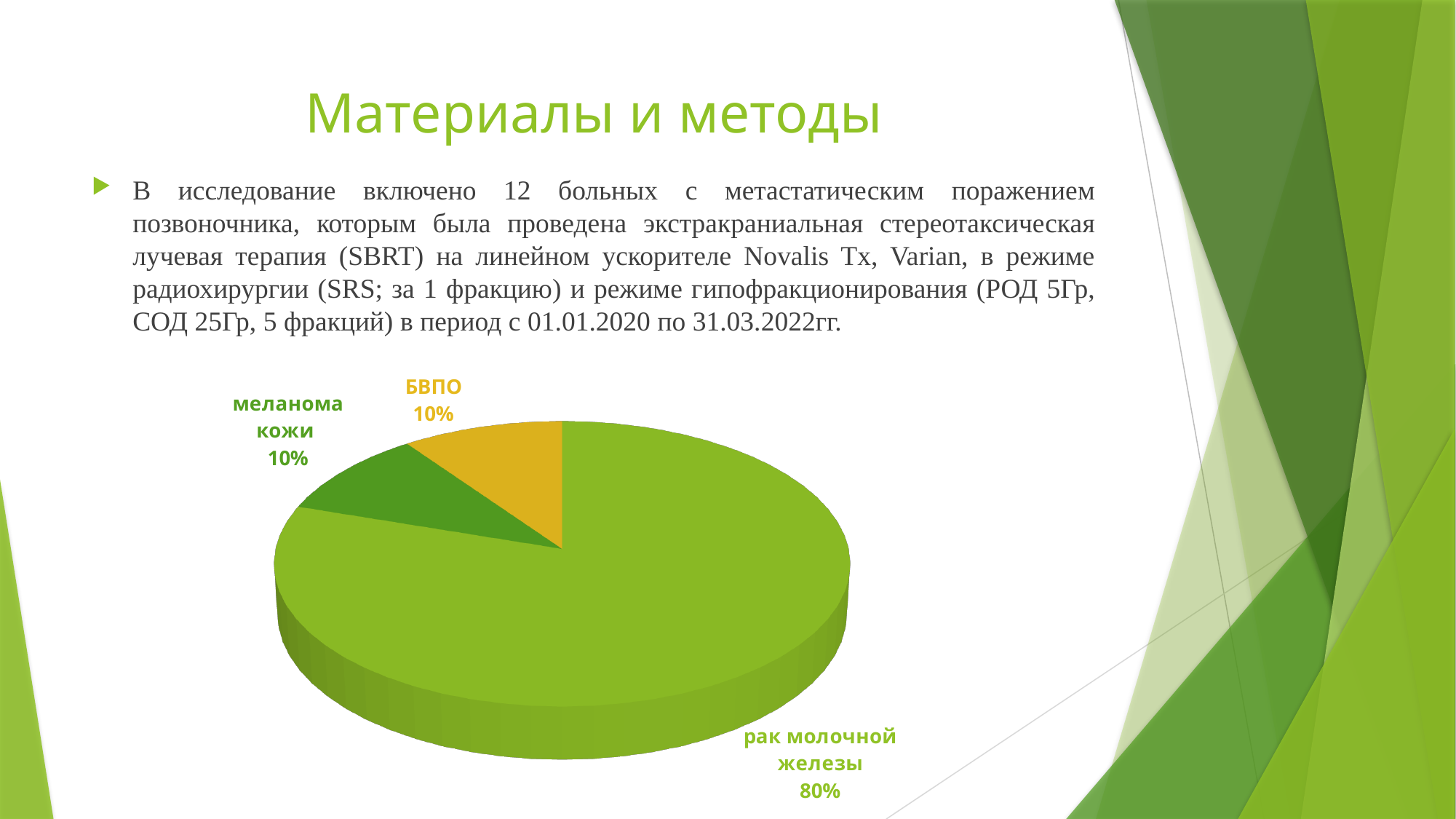
What share of the pie does БВПО have? 10% What is the difference in percentage points between рак молочной железы and БВПО? 70 Which is larger, the slice for рак молочной железы or the slice for меланома кожи? рак молочной железы What share of the pie does меланома кожи have? 10% What colour is the БВПО slice? yellow Is the share for рак молочной железы greater or less than 50%? greater Which category has the largest slice of the pie? рак молочной железы How many slices does the pie chart have? 3 What kind of chart is shown on the slide? pie chart What share of the pie does рак молочной железы have? 80% What is the combined share of меланома кожи and БВПО? 20%